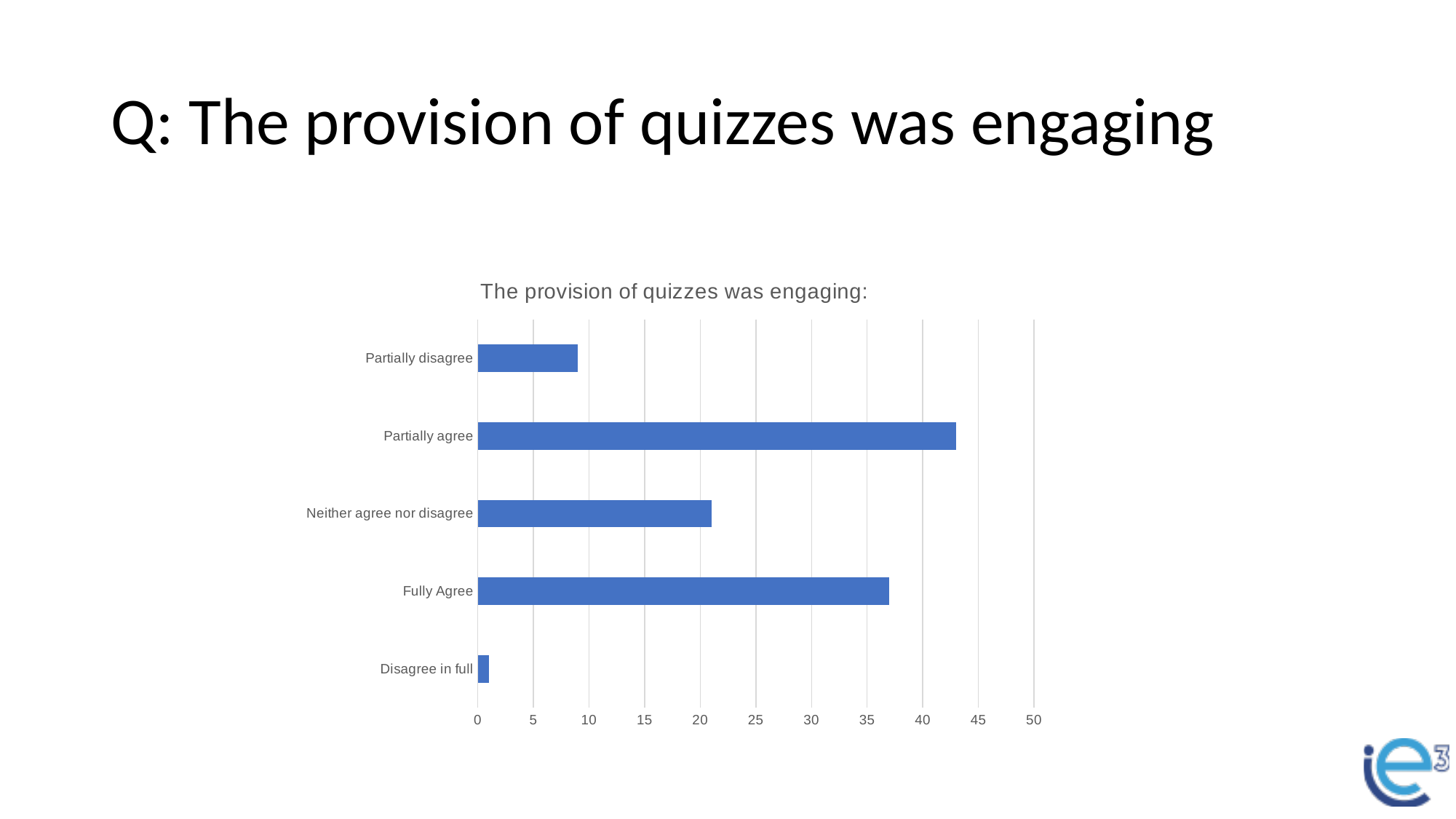
What is the title of the chart? The provision of quizzes was engaging: Is the value for Neither agree nor disagree greater or less than 25? less Which is larger, the value for Partially disagree or the value for Partially agree? Partially agree Which category has the highest value? Partially agree Which category has the lowest value? Disagree in full How many categories are shown in the chart? 5 Which is larger, the value for Fully Agree or the value for Neither agree nor disagree? Fully Agree Is the value for Fully Agree greater or less than 35? greater What kind of chart is shown on the slide? bar chart Is the value for Disagree in full greater or less than 5? less